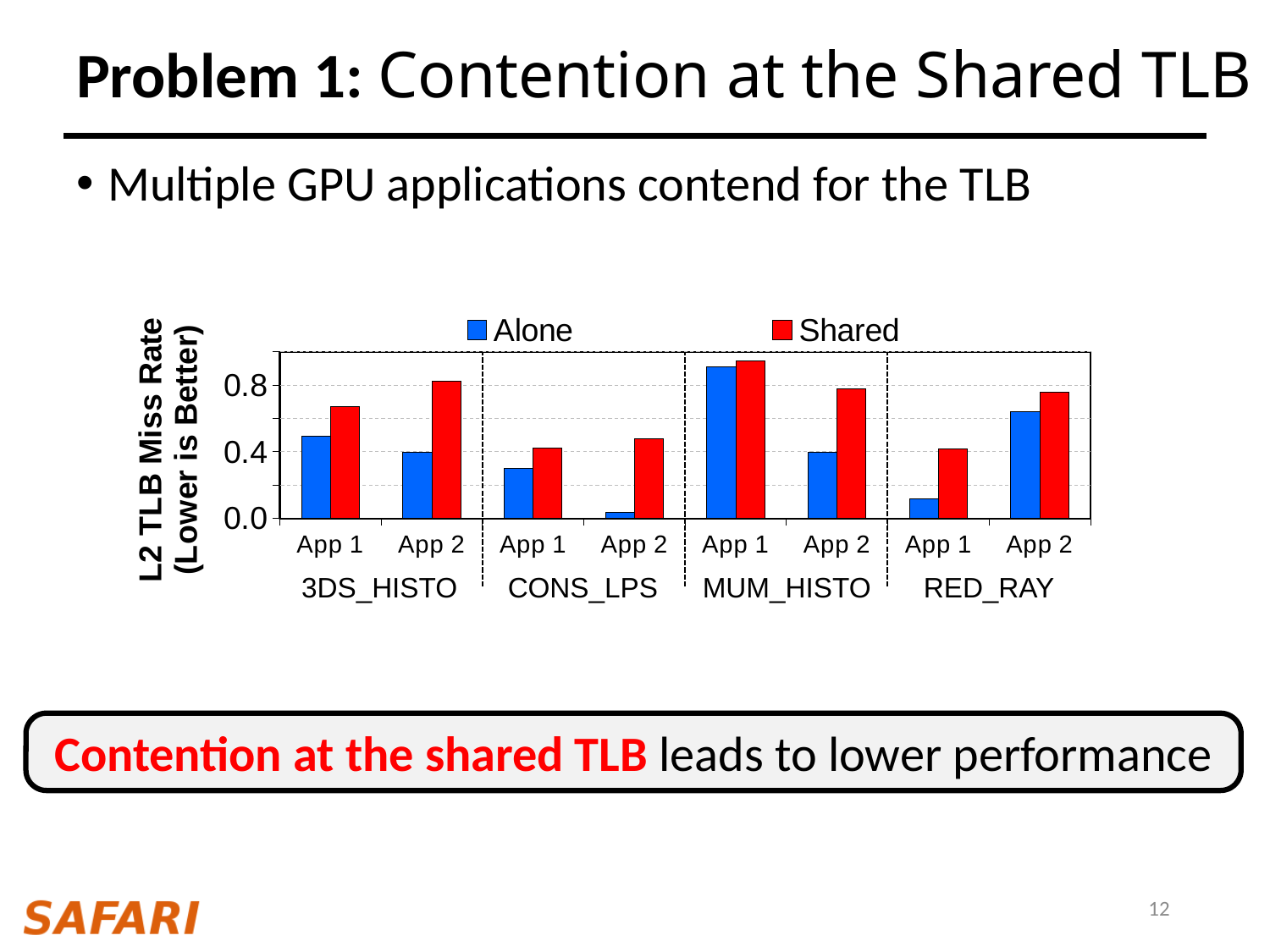
How many workload groups are shown along the x axis of the chart? 4 For RED_RAY App 1, which is larger: the Alone value or the Shared value? Shared Which application has the lowest Alone L2 TLB miss rate? CONS_LPS App 2 Is the Shared value for 3DS_HISTO App 1 greater or less than 0.4? greater What kind of chart is shown on the slide? bar chart For CONS_LPS App 2, which is larger: the Alone value or the Shared value? Shared What are the two series named in the chart legend? Alone and Shared Is the Alone value for MUM_HISTO App 1 greater or less than 0.8? greater Is the Alone value for RED_RAY App 1 greater or less than 0.4? less How many series does the chart legend list? 2 What is the y-axis label of the chart? L2 TLB Miss Rate (Lower is Better) Which application has the highest Shared L2 TLB miss rate? MUM_HISTO App 1